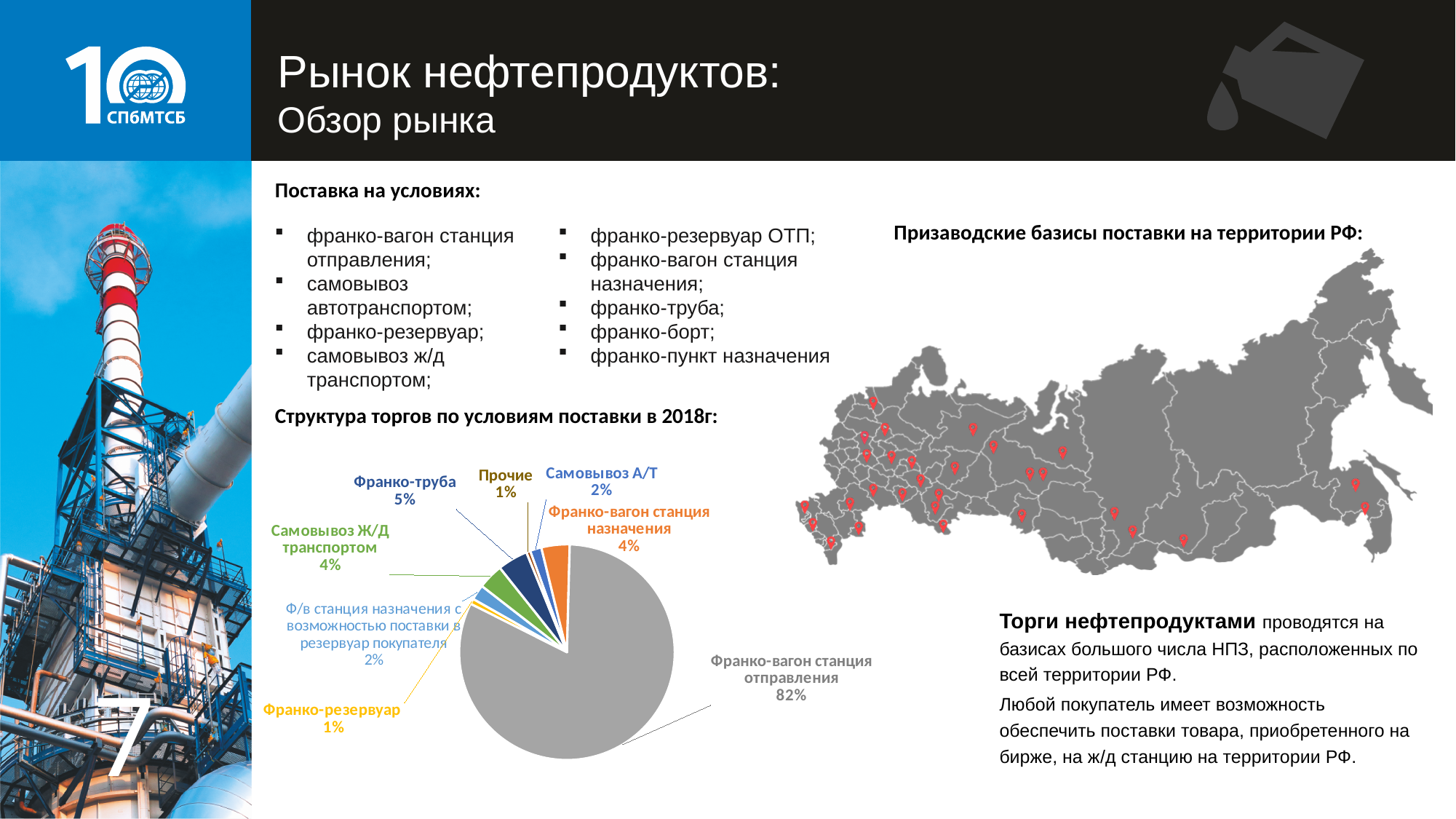
What is the title of the pie chart on the slide? Структура торгов по условиям поставки в 2018г Which category has the largest slice in the pie chart? Франко-вагон станция отправления What is the difference between the shares of "Франко-вагон станция отправления" and "Франко-труба" in the pie chart? 77% Which is larger in the pie chart: "Франко-труба" or "Самовывоз А/Т"? Франко-труба What is the value shown for "Франко-труба" in the pie chart? 5% What is the value shown for "Самовывоз А/Т" in the pie chart? 2% What is the value shown for "Самовывоз Ж/Д транспортом" in the pie chart? 4% What share of the pie chart does "Франко-вагон станция отправления" have? 82% How many slices does the pie chart have? 8 What kind of chart is shown under the heading "Структура торгов по условиям поставки в 2018г"? pie chart What is the difference between the shares of "Франко-вагон станция назначения" and "Прочие" in the pie chart? 3% What is the value shown for "Франко-резервуар" in the pie chart? 1%